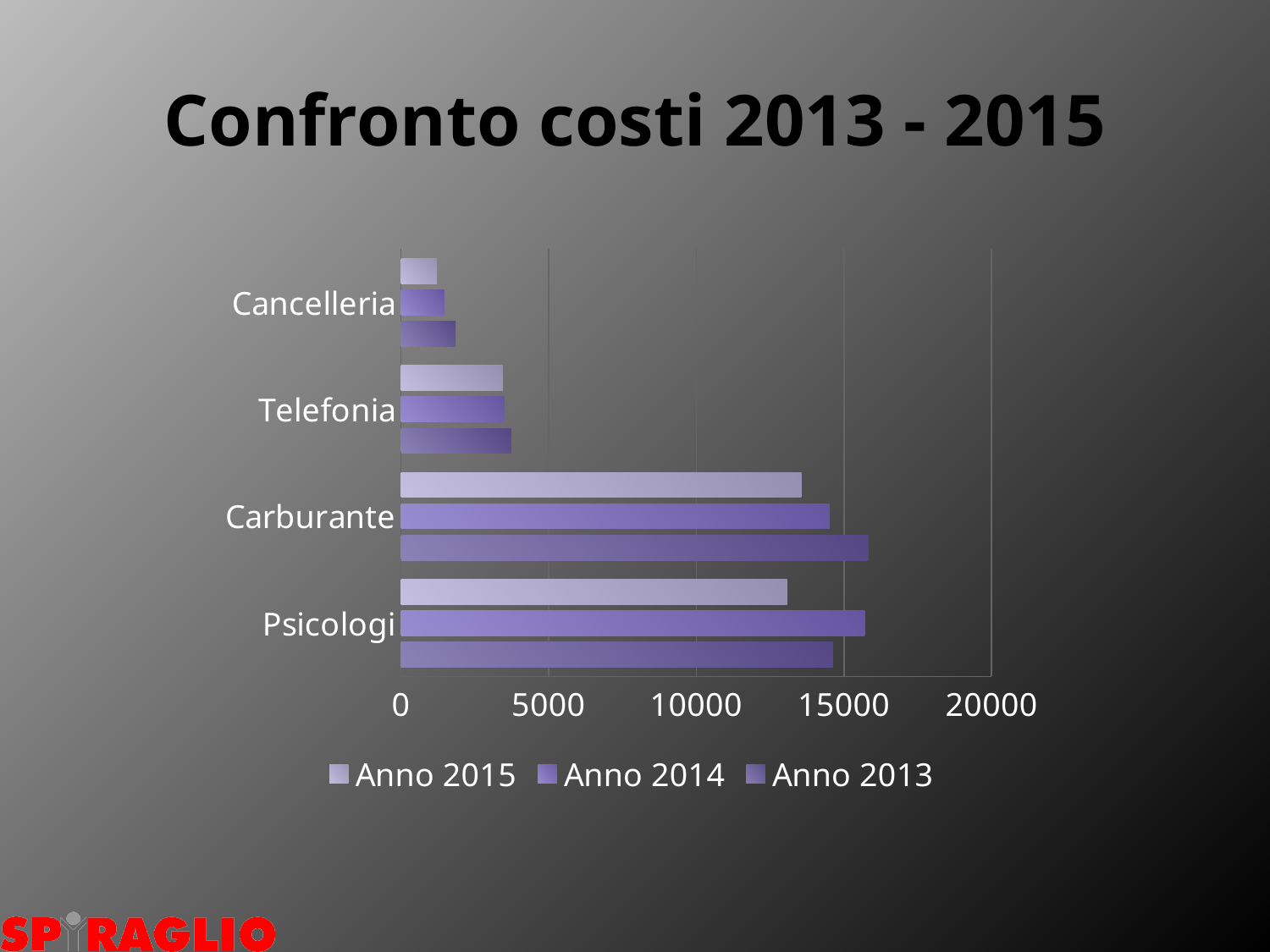
What kind of chart is shown on the slide? bar chart For Psicologi, which year has the higher value: Anno 2014 or Anno 2015? Anno 2014 Which series are listed in the legend? Anno 2015, Anno 2014, Anno 2013 How many series does the legend list? 3 What is the title of the chart? Confronto costi 2013 - 2015 Is the value for Psicologi in Anno 2014 greater or less than 15000? greater Is the value for Psicologi in Anno 2015 greater or less than 15000? less For Carburante, which year has the higher value: Anno 2013 or Anno 2015? Anno 2013 Is the value for Carburante in Anno 2013 greater or less than 15000? greater How many categories are shown on the chart? 4 Which category has the lowest values across all three years? Cancelleria